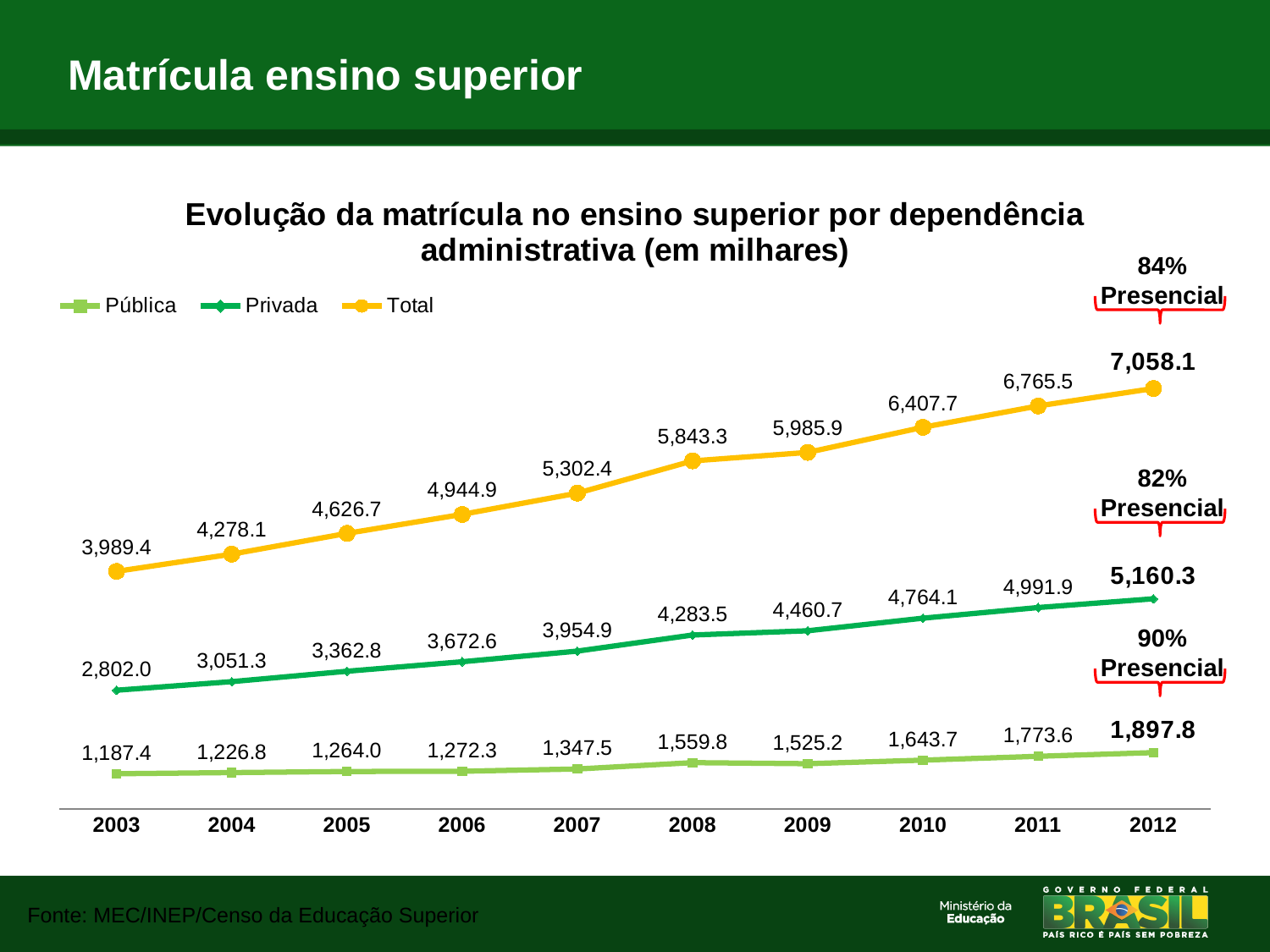
What is the difference between the Privada and Pública values in 2012? 3,262.5 What kind of chart is shown on the slide? Line chart What is the value of the Privada series in 2008? 4,283.5 In which year is the Pública series at its highest? 2012 In which year is the Total series at its lowest? 2003 How many years are shown on the x axis? 10 What is the difference between the Total value in 2012 and the Total value in 2003? 3,068.7 What is the value of the Pública series in 2003? 1,187.4 Does the Total series rise or fall from 2003 to 2012? Rise How many series does the legend list? 3 Which year has the larger Pública value, 2008 or 2009? 2008 What is the value of the Total series in 2012? 7,058.1